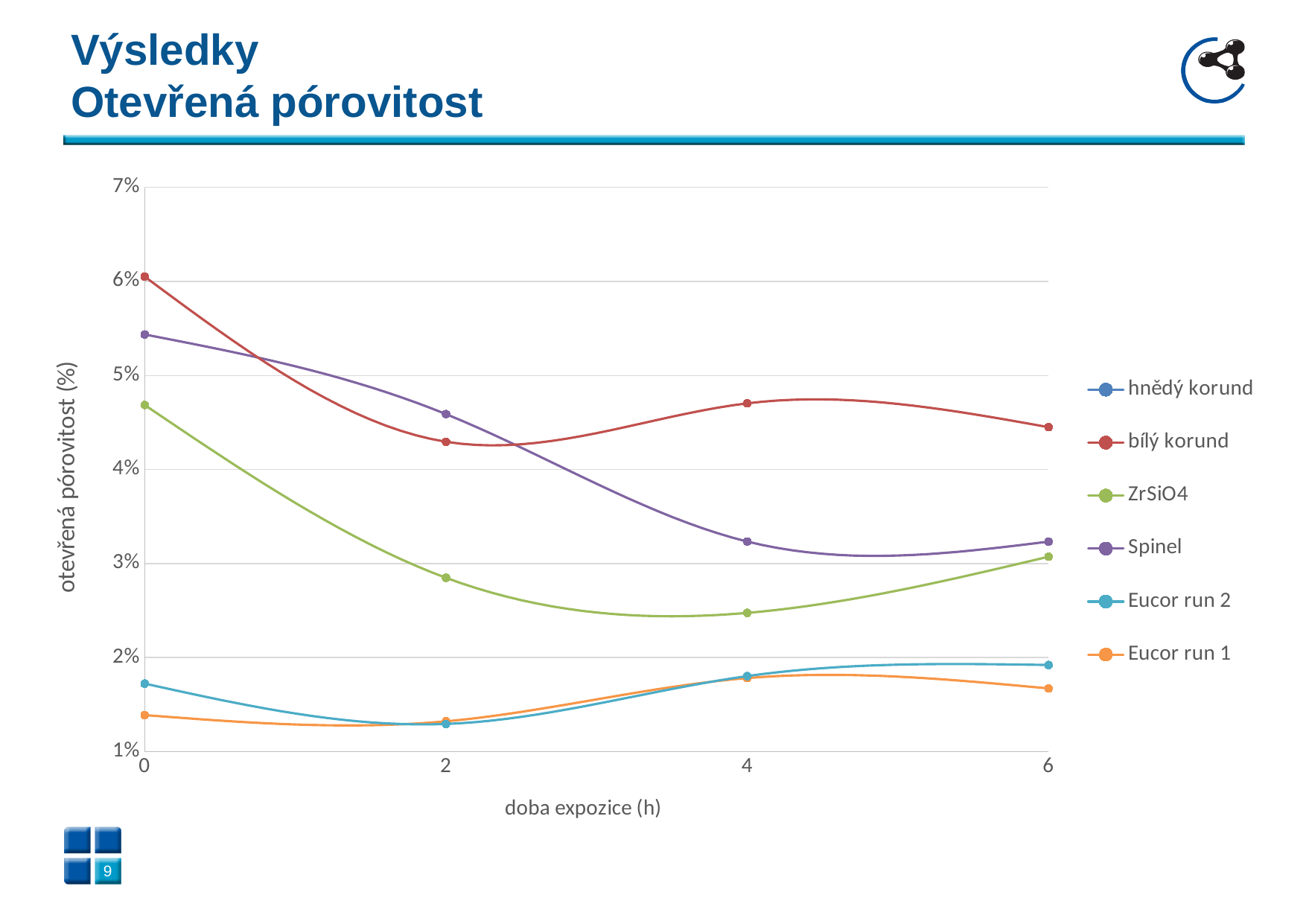
Which series has the lowest open porosity at 0 h? Eucor run 1 Does the bílý korund series rise or fall between 2 h and 4 h? rise How many series does the legend list? 6 At 6 h, which is larger: bílý korund or Spinel? bílý korund Is the value for ZrSiO4 at 4 h greater or less than 3%? less What is the title of the x axis? doba expozice (h) Which series has the highest open porosity at 0 h? bílý korund Does the Spinel series rise or fall between 0 h and 4 h? fall What kind of chart is shown on the slide? line chart Is the value for bílý korund at 0 h greater or less than 5%? greater How many exposure-time points are marked on the x axis? 4 Is the value for Spinel at 2 h greater or less than 4%? greater